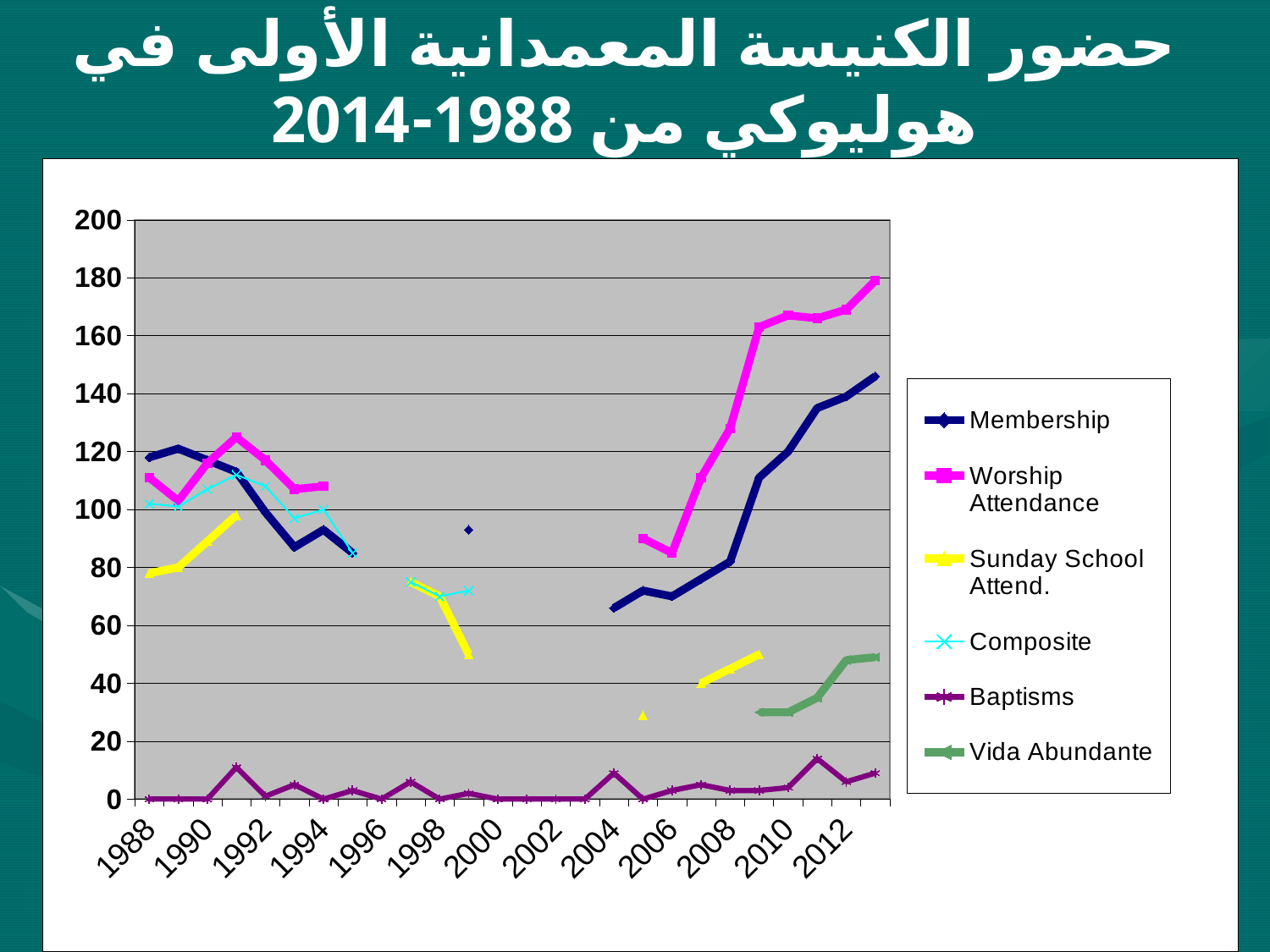
Does Worship Attendance rise or fall from 2006 to 2012? rise Which series reaches the highest value anywhere on the chart? Worship Attendance Does Membership rise or fall from 1992 to 1995? fall In 2012, which is higher, Membership or Worship Attendance? Worship Attendance How many series does the legend list? 6 What kind of chart is shown on the slide? line chart Which series is drawn in yellow? Sunday School Attend. Is the value for Baptisms in 2012 greater or less than 20? less Is the value for Worship Attendance in 2012 greater or less than 160? greater Is the value for Sunday School Attend. in 1988 greater or less than 100? less